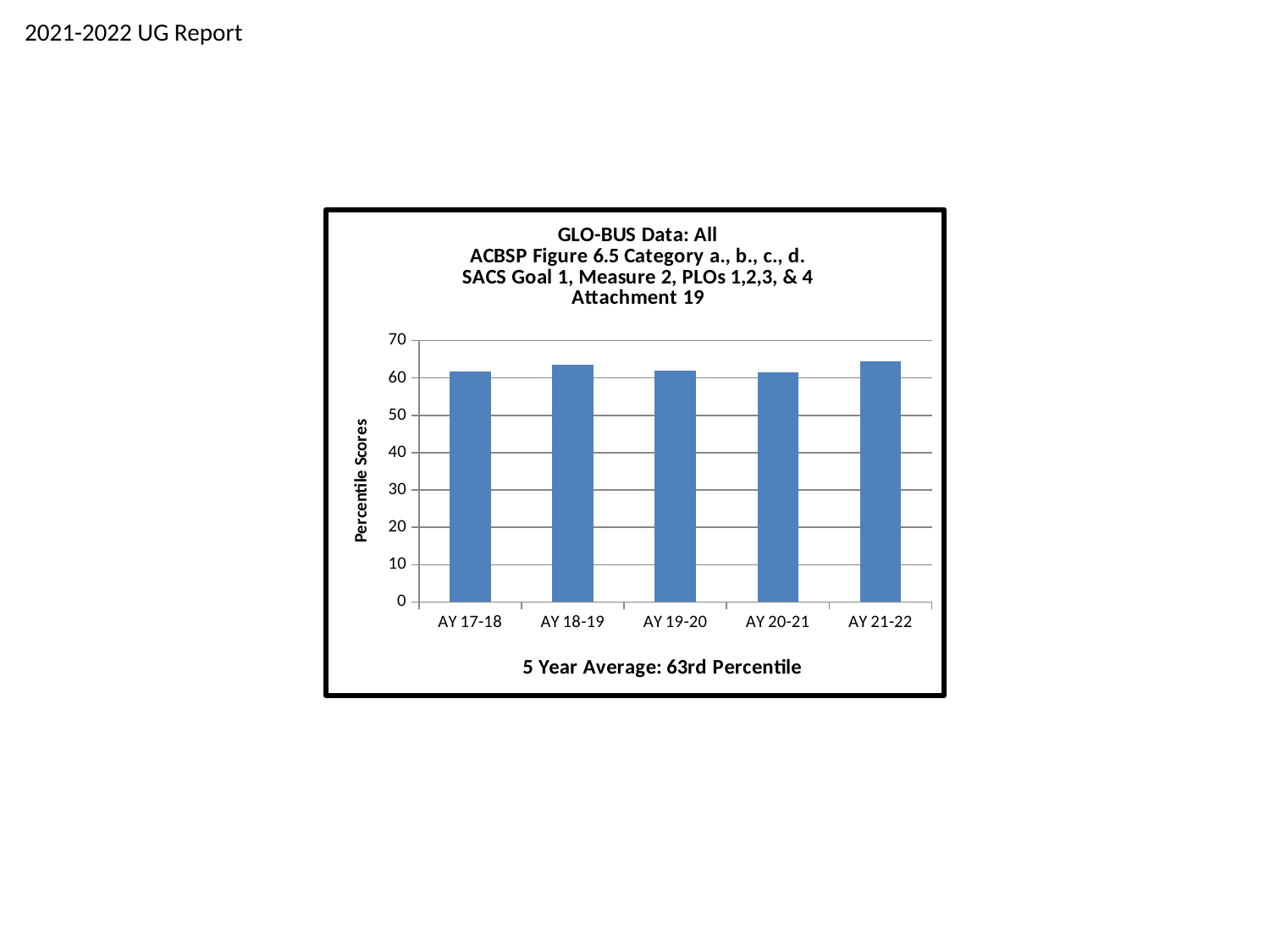
Which is larger, the value for AY 21-22 or the value for AY 17-18? AY 21-22 Is the value for AY 21-22 greater or less than 70? less What is the label on the vertical axis of the chart? Percentile Scores Is the value for AY 18-19 greater or less than 60? greater Which academic year has the highest percentile score? AY 21-22 Is the value for AY 20-21 greater or less than 50? greater What kind of chart is shown on the slide? bar chart Which is larger, the value for AY 18-19 or the value for AY 20-21? AY 18-19 How many academic years are plotted on the chart? 5 What 5 year average is stated below the chart? 63rd Percentile